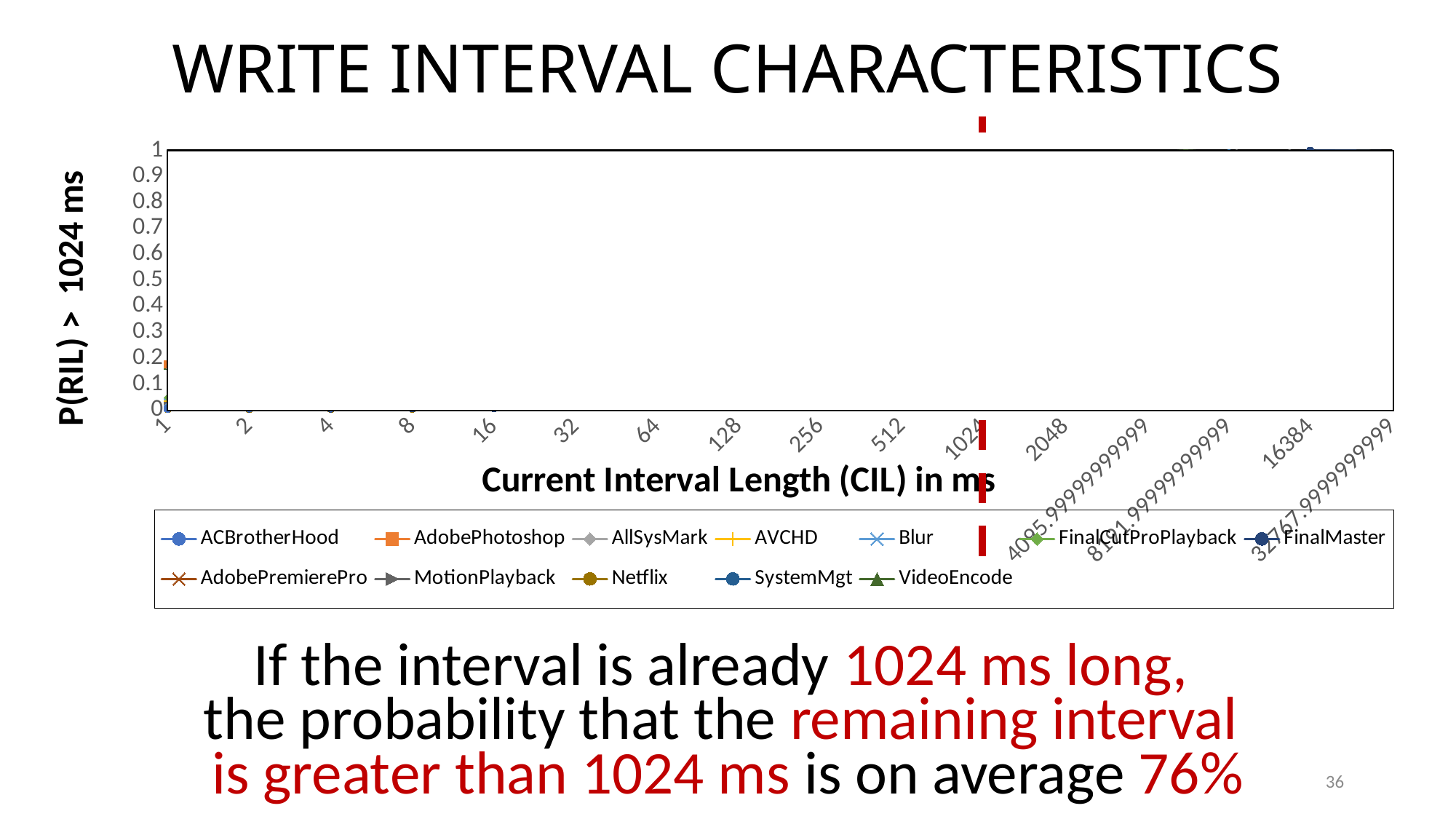
What is the highest value shown on the y axis? 1 What is the title of the x axis? Current Interval Length (CIL) in ms How many categories are shown along the x axis? 16 What kind of chart is shown on the slide? line chart How many series does the legend list? 12 What is the title of the y axis? P(RIL) > 1024 ms